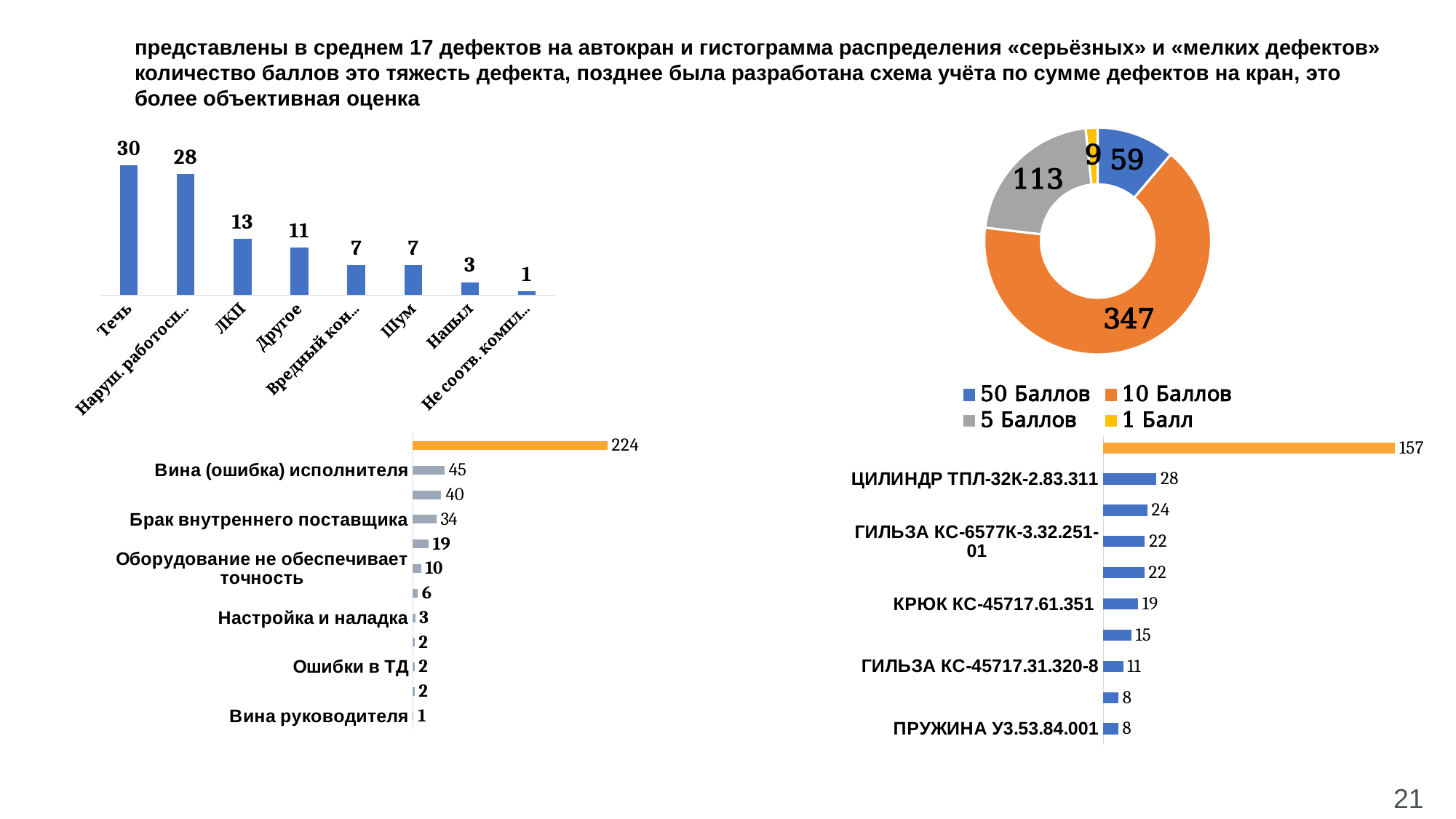
In the top-right donut chart, what colour is the 5 Баллов segment? Grey In the top-left bar chart, what is the value for ЛКП? 13 In the bottom-left bar chart, which is larger: Вина (ошибка) исполнителя or Настройка и наладка? Вина (ошибка) исполнителя In the top-left bar chart, what is the difference between the values for Течь and Другое? 19 In the top-left bar chart, what is the value for Течь? 30 In the top-right donut chart, what is the value for 10 Баллов? 347 In the top-right donut chart, which segment is the smallest? 1 Балл In the bottom-left bar chart, what is the value for Брак внутреннего поставщика? 34 In the top-left bar chart, which category has the highest value? Течь In the top-left bar chart, how many categories are shown? 8 In the top-right donut chart, how many entries does the legend list? 4 In the bottom-right bar chart, what is the value for ЦИЛИНДР ТПЛ-32К-2.83.311? 28